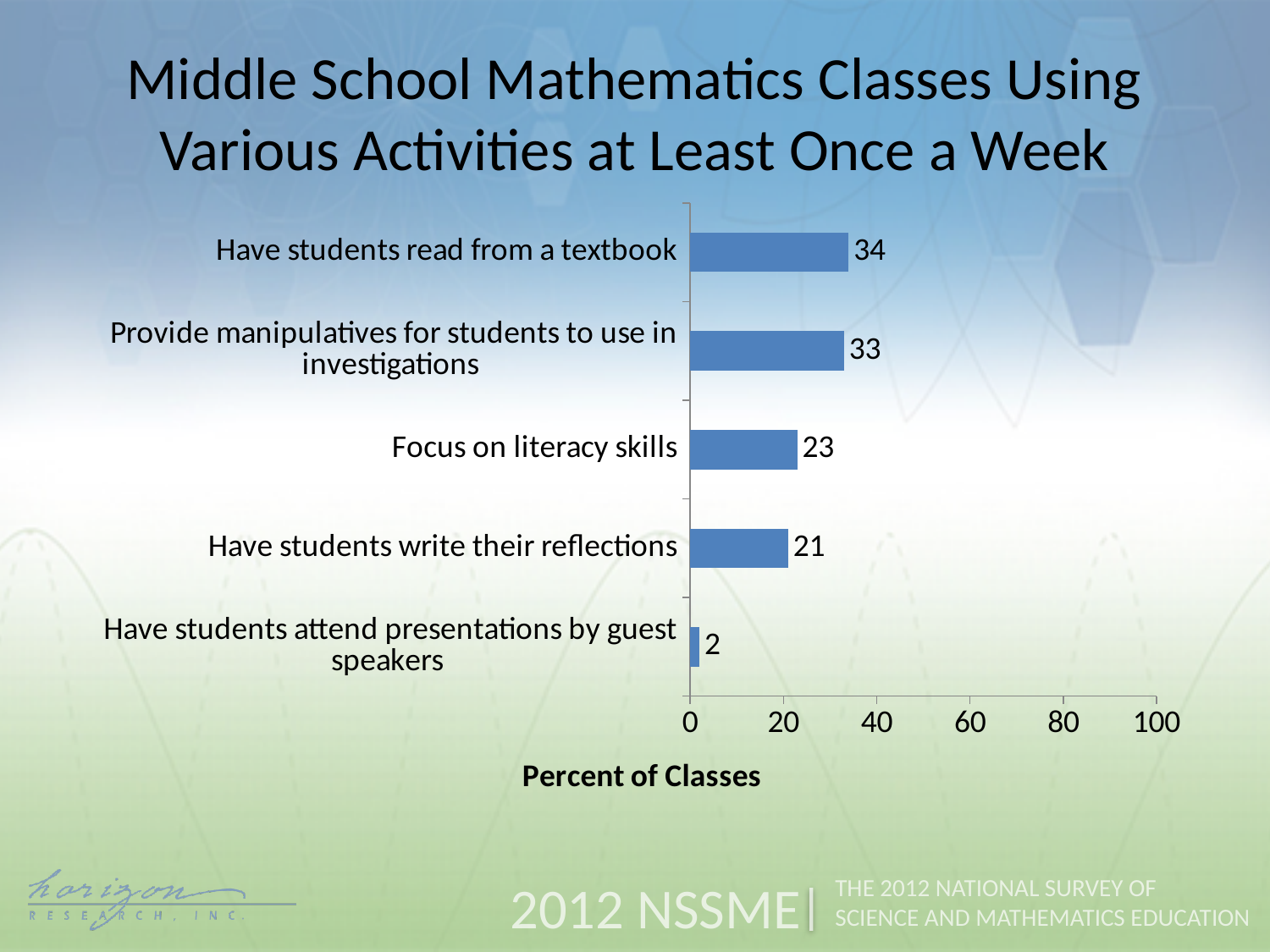
How many activities are shown in the chart? 5 What is the label of the horizontal axis? Percent of Classes Which activity has the lowest percent of classes? Have students attend presentations by guest speakers What is the difference between the values for 'Focus on literacy skills' and 'Have students write their reflections'? 2 What is the difference between the values for 'Have students read from a textbook' and 'Have students attend presentations by guest speakers'? 32 Which activity has the highest percent of classes? Have students read from a textbook What percent of classes have students read from a textbook at least once a week? 34 What is the value for 'Provide manipulatives for students to use in investigations'? 33 What is the value for 'Focus on literacy skills'? 23 Which is larger: the value for 'Focus on literacy skills' or 'Have students attend presentations by guest speakers'? Focus on literacy skills What kind of chart is shown on the slide? Bar chart What is the value for 'Have students write their reflections'? 21